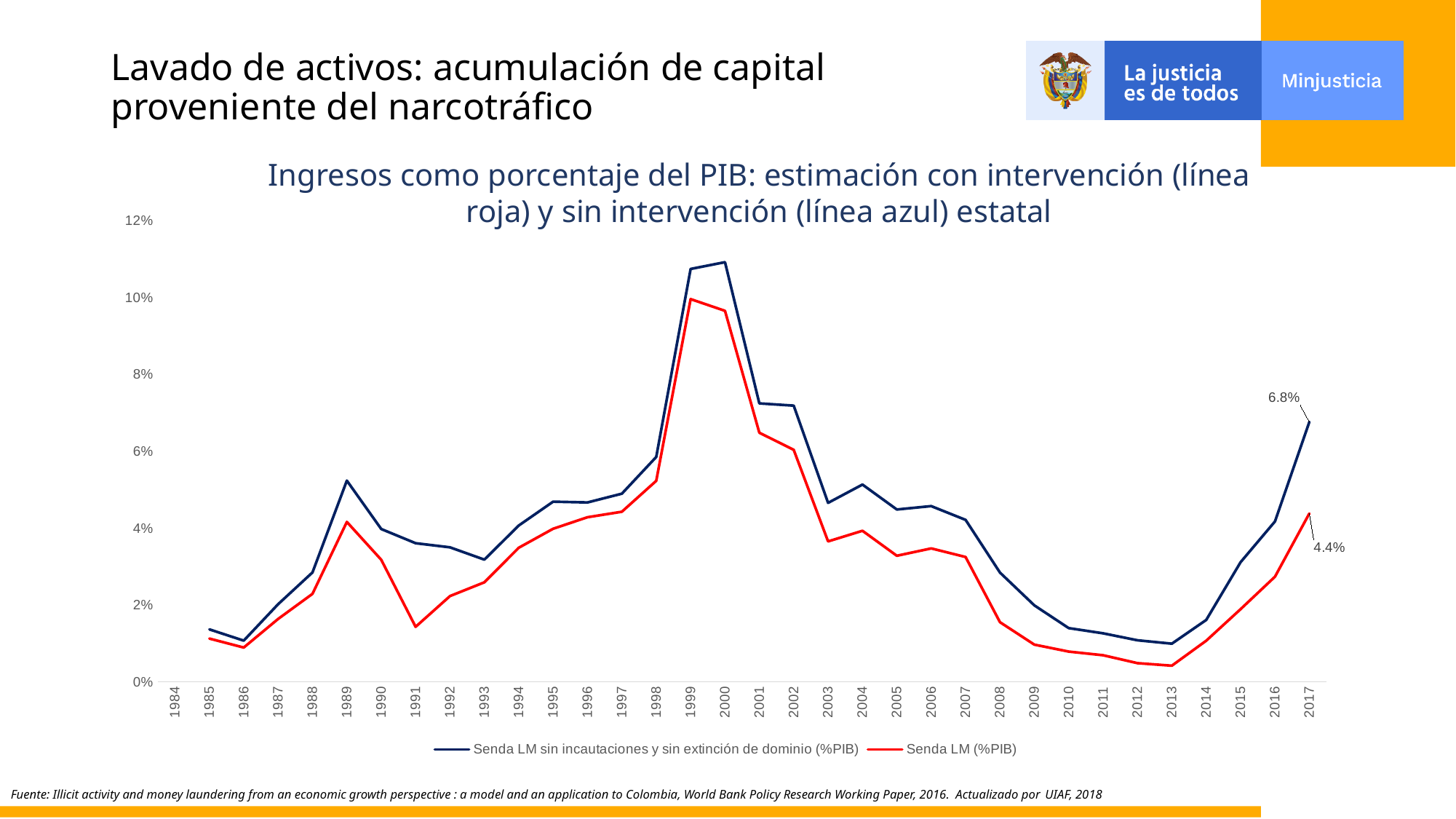
What is the value of the blue line (Senda LM sin incautaciones y sin extinción de dominio) in 2017? 6.8% In which year does the red line (Senda LM (%PIB)) reach its highest value? 1999 How many series does the legend list? 2 In 2000, which line has the higher value, the blue line or the red line? the blue line In which year does the red line (Senda LM (%PIB)) reach its lowest value? 2013 Do the values of both lines rise or fall between 2013 and 2017? rise Is the value of the blue line in 1999 greater or less than 10%? greater Is the value of the red line in 1991 greater or less than 2%? less What kind of chart is shown on the slide? line chart What is the value of the red line (Senda LM (%PIB)) in 2017? 4.4% What colour is the line for the series 'Senda LM (%PIB)'? red What is the difference between the blue line and the red line values in 2017? 2.4%